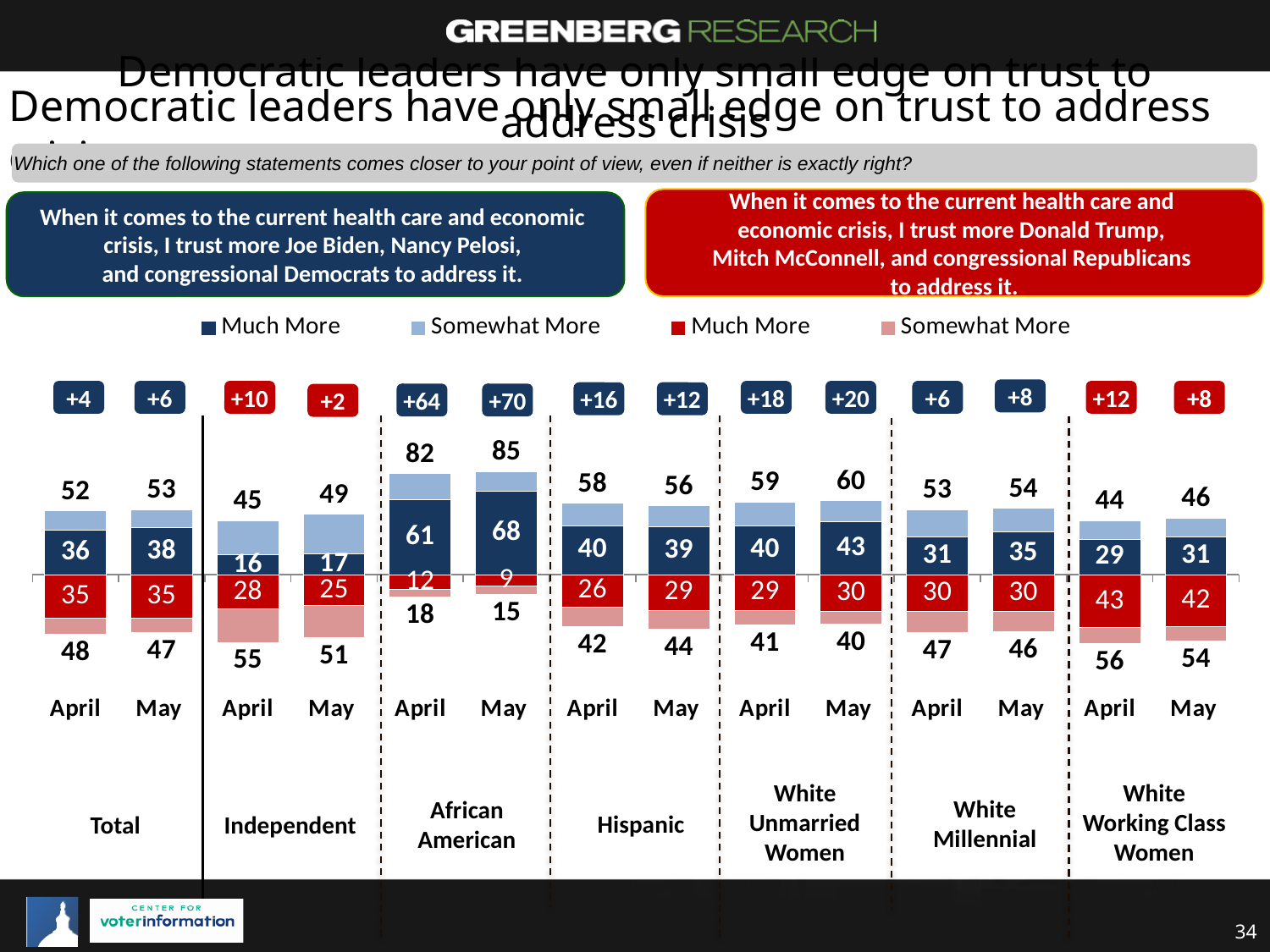
Which group has the lowest total share trusting Republican leaders more in May? African American What is the net margin shown above the May bar for White Unmarried Women? +20 How many series does the legend list? 4 What is the 'Much More' value for Democratic leaders among Hispanic respondents in April? 40 What is the total share of African American respondents in May who trust Democratic leaders more (the top label above the blue bar)? 85 Which is larger for the Total group in May: the Democratic total (53) or the Republican total (47)? Democratic total (53) What kind of chart is shown on the slide? Stacked bar chart What is the difference between the Democratic total for Independents in May (49) and in April (45)? 4 What is the total share of White Working Class Women in April who trust Republican leaders more (the bottom label below the red bar)? 56 Which group has the highest total share trusting Democratic leaders more in May? African American What is the Republican 'Much More' value for White Millennial respondents in April? 30 How many demographic groups are shown along the x axis of the chart? 7